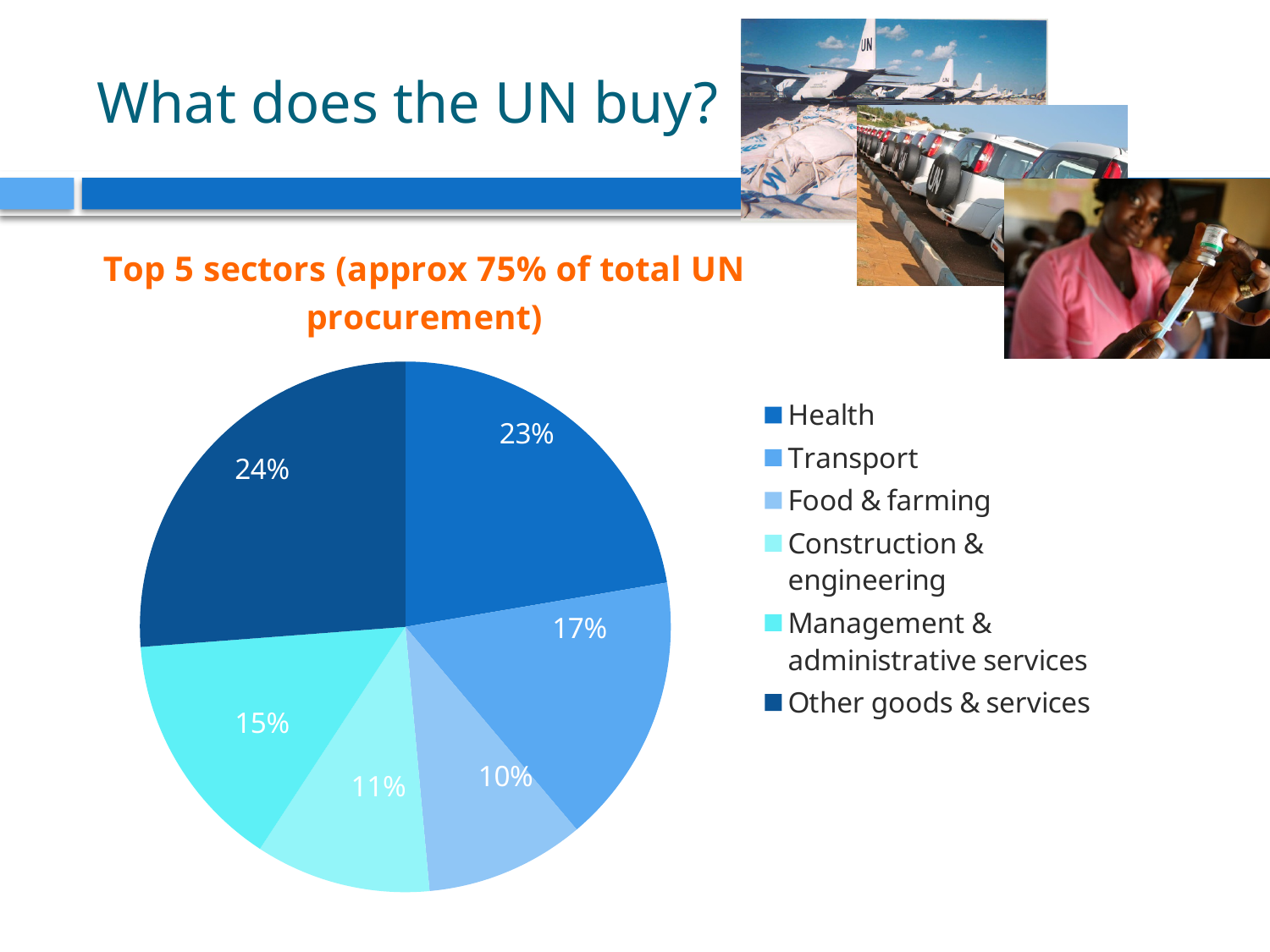
What percentage of the pie is Other goods & services? 24% What share does Food & farming have in the pie chart? 10% What percentage is shown for Construction & engineering? 11% Which slice of the pie chart is the largest? Other goods & services What type of chart is shown on the slide? Pie chart Which is larger, Management & administrative services or Construction & engineering? Management & administrative services Which sector has the smallest slice in the pie chart? Food & farming What percentage of the pie chart is Transport? 17% What share of UN procurement does the Health sector account for in the pie chart? 23% What share does Management & administrative services have in the pie chart? 15% How many percentage points larger is Health than Transport? 6 How many slices does the pie chart have? 6